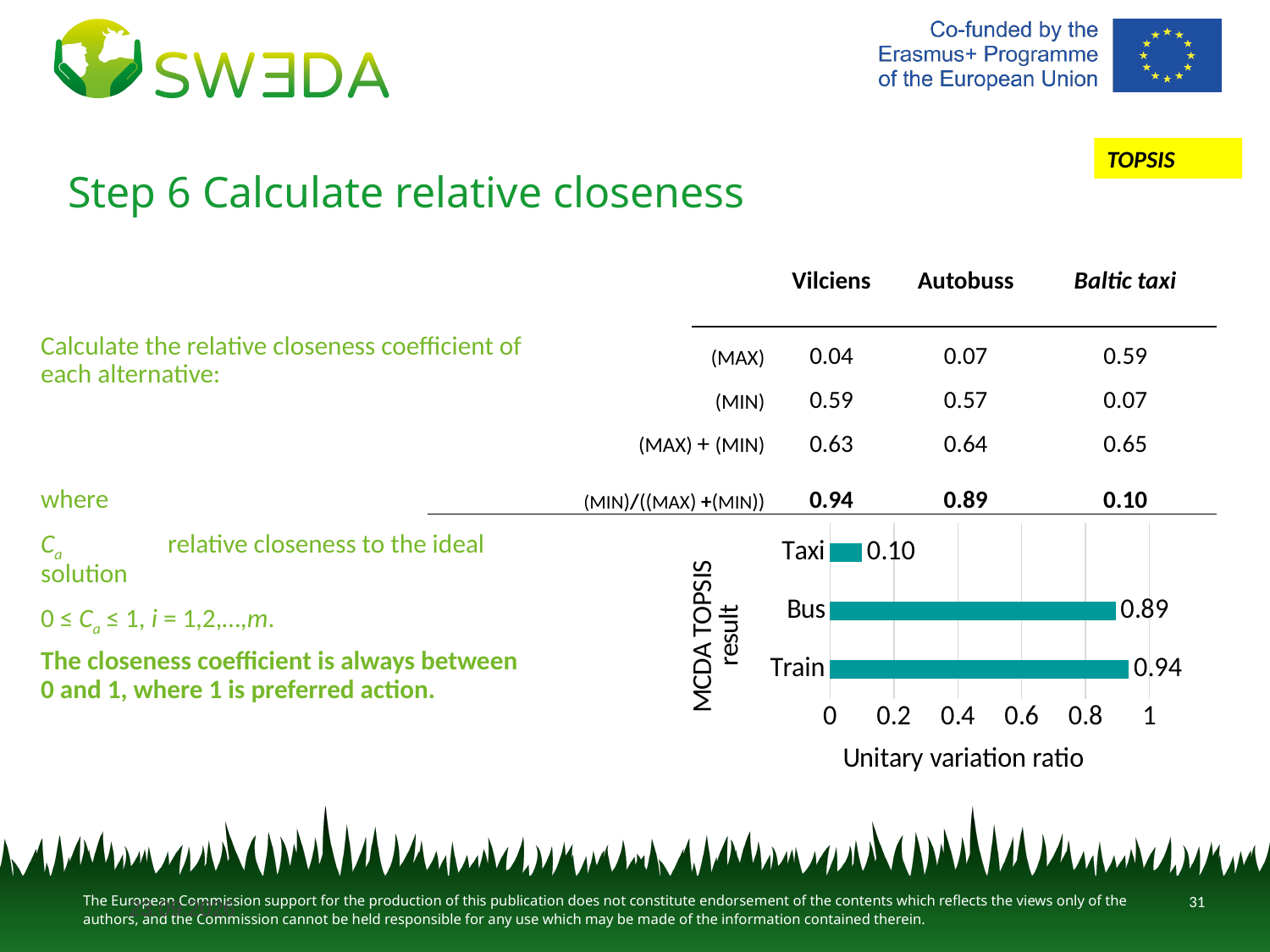
Which is larger in the bar chart, the value for Bus or the value for Taxi? Bus How many categories are shown in the bar chart? 3 Is the value for Taxi in the bar chart greater or less than 0.2? less What is the label of the horizontal axis of the bar chart? Unitary variation ratio Which category has the highest value in the bar chart? Train Which category has the lowest value in the bar chart? Taxi What is the difference between the values for Bus and Taxi in the bar chart? 0.79 What is the value for Train in the bar chart? 0.94 What kind of chart is shown on the slide? bar chart What is the difference between the values for Train and Bus in the bar chart? 0.05 What is the value for Taxi in the bar chart? 0.10 What is the value for Bus in the bar chart? 0.89